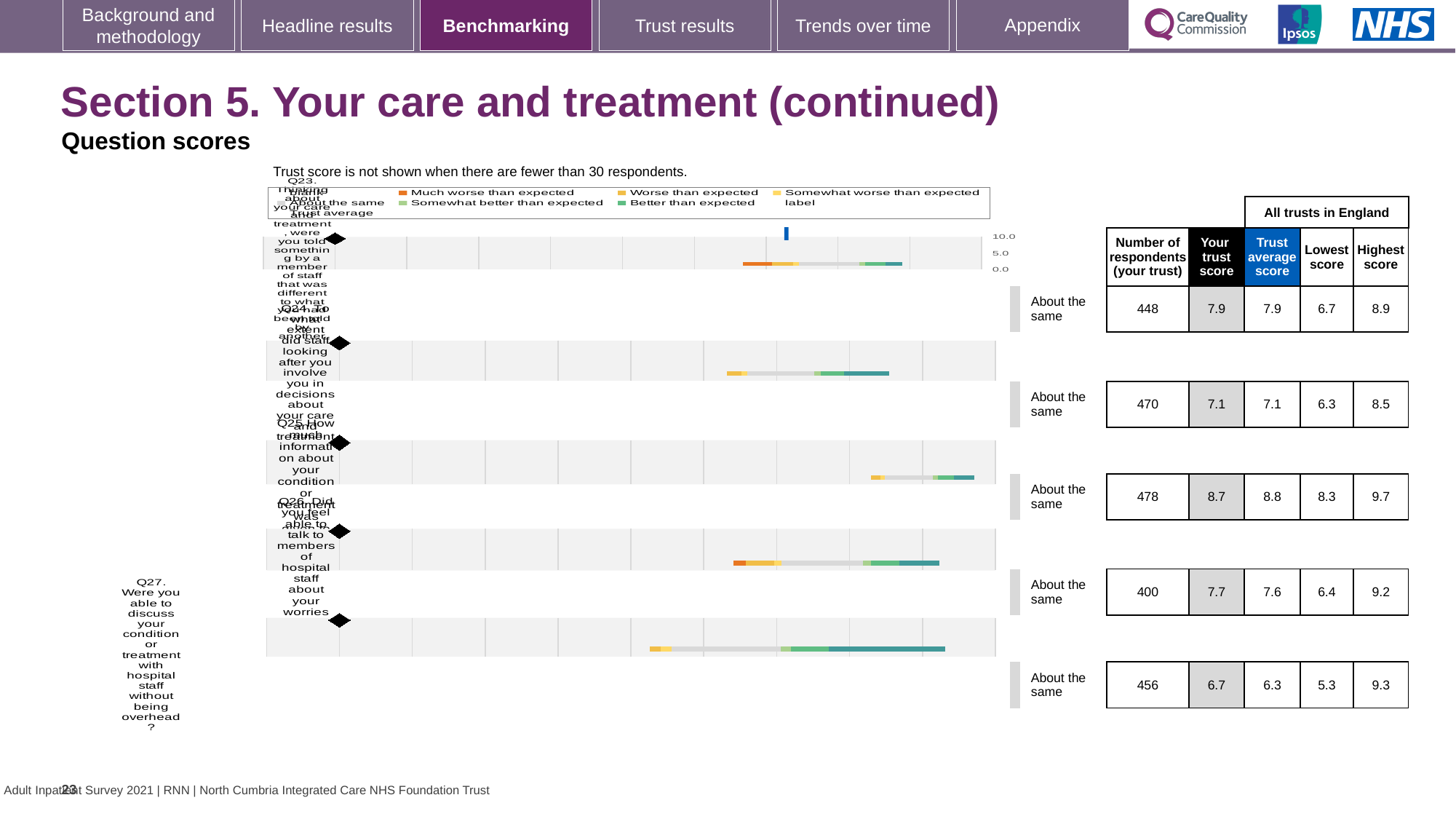
How many questions are shown on this slide? 5 What benchmark category is shown for every question on this slide? About the same For Q26, which is larger: the trust score or the trust average score? Trust score What is the highest score across all trusts in England for Q27? 9.3 How many respondents answered Q25 (information about your condition or treatment)? 478 What is the trust score for Q27 (discussing your condition or treatment without being overheard)? 6.7 What is the lowest score across all trusts in England for Q23? 6.7 What is the difference between the trust score and the trust average score for Q27? 0.4 What is the trust average score for Q24 (staff involving you in decisions about your care and treatment)? 7.1 What kind of chart is used to show the question scores? Bar chart Which question has the highest trust score on this slide? Q25 Which question has the lowest trust score on this slide? Q27